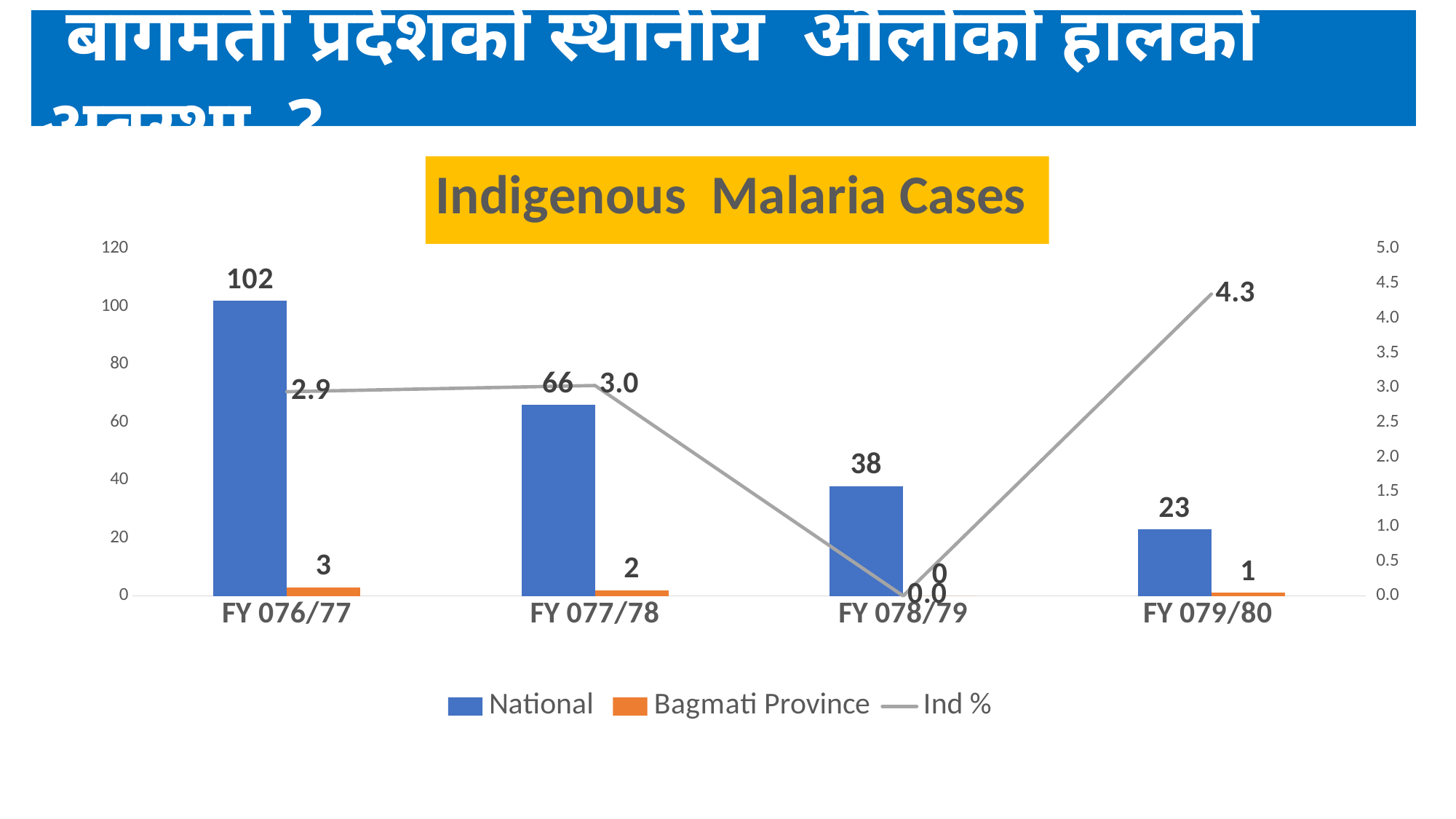
Which fiscal year has the highest National value? FY 076/77 How many series does the legend list? 3 What is the National value for FY 078/79? 38 What is the title of the chart? Indigenous Malaria Cases Which fiscal year has the lowest Bagmati Province value? FY 078/79 How many fiscal years are shown on the x axis? 4 What is the National value for FY 076/77? 102 What is the difference between the National values for FY 076/77 and FY 077/78? 36 Do the National values rise or fall from FY 076/77 to FY 079/80? fall What is the Ind % value for FY 079/80? 4.3 What is the Bagmati Province value for FY 077/78? 2 Which is larger, the National value for FY 078/79 or for FY 079/80? FY 078/79